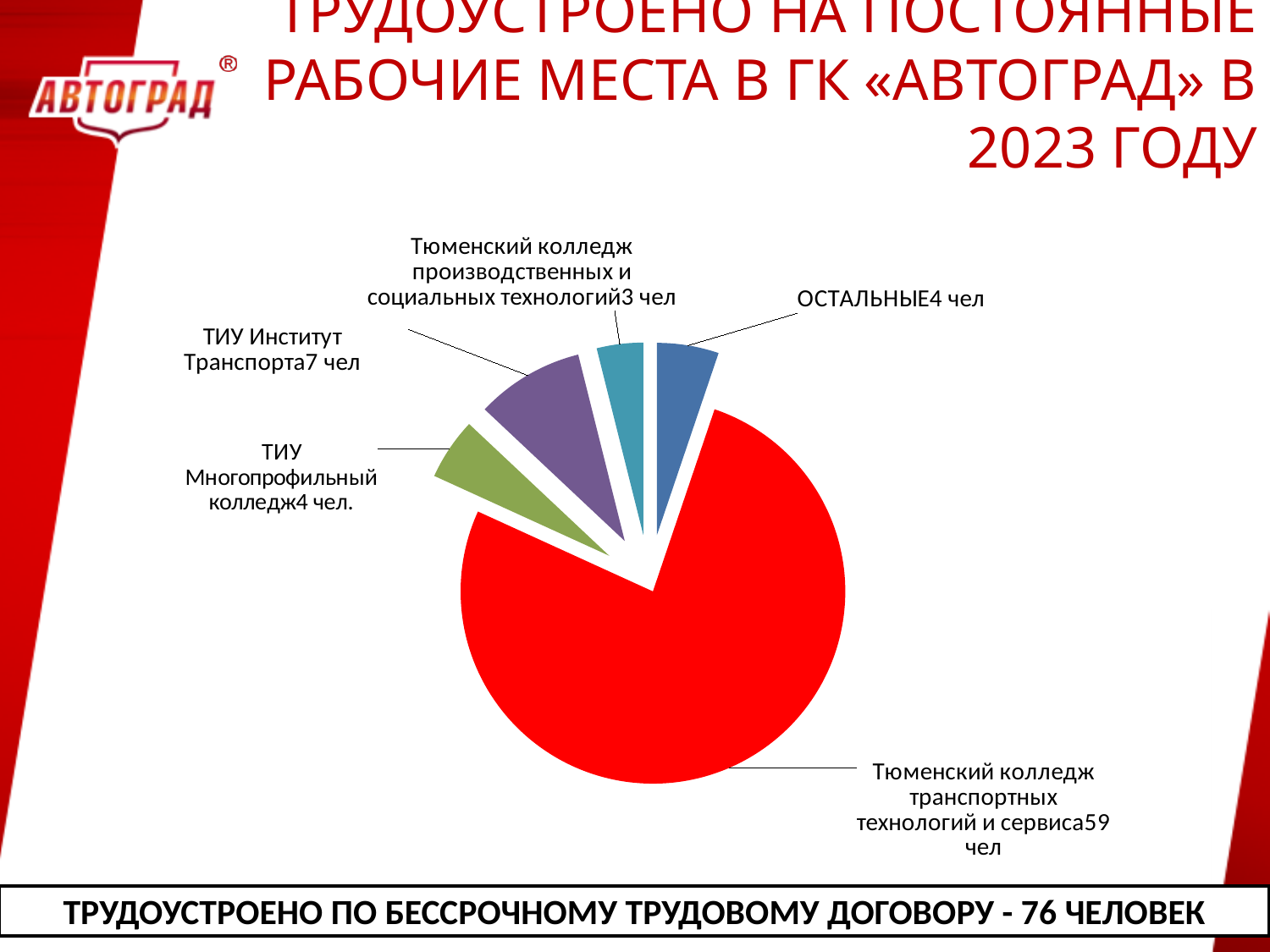
How many people were employed from Тюменский колледж транспортных технологий и сервиса according to the pie chart? 59 чел What value is shown for the ОСТАЛЬНЫЕ slice of the pie chart? 4 чел What colour is the slice for Тюменский колледж транспортных технологий и сервиса? Red According to the text at the bottom of the slide, how many people were employed under an open-ended employment contract? 76 человек Which category has the largest slice in the pie chart? Тюменский колледж транспортных технологий и сервиса How many slices does the pie chart have? 5 What type of chart is shown on the slide? Pie chart What value is shown for ТИУ Институт Транспорта in the pie chart? 7 чел Which category has the smallest slice in the pie chart? Тюменский колледж производственных и социальных технологий What is the difference between the values for Тюменский колледж транспортных технологий и сервиса and ТИУ Институт Транспорта? 52 чел Which is larger: the value for ТИУ Институт Транспорта or the value for ТИУ Многопрофильный колледж? ТИУ Институт Транспорта What value is shown for ТИУ Многопрофильный колледж in the pie chart? 4 чел